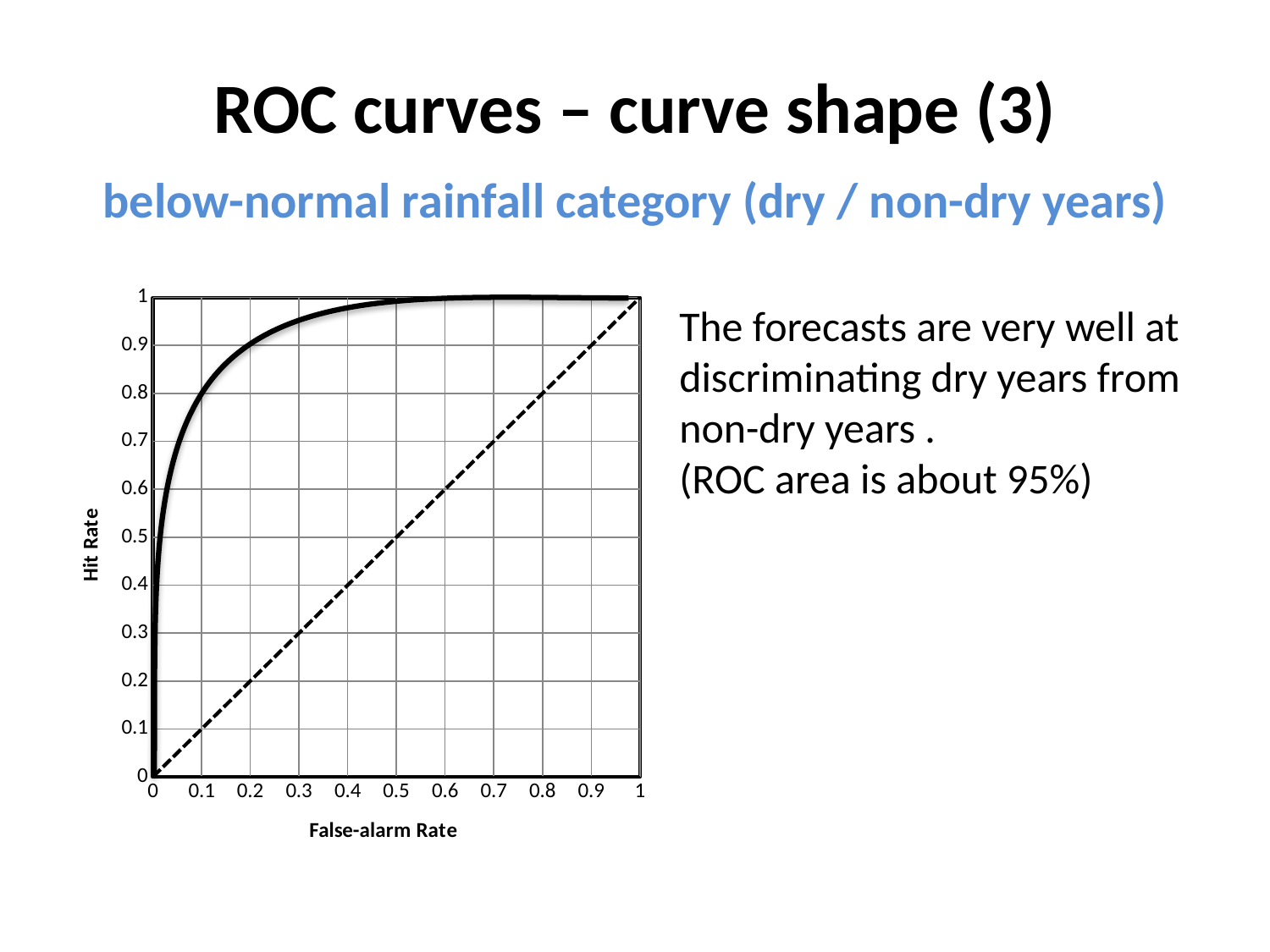
What is the hit rate of the solid curve when the false-alarm rate is 1? 1 What is the hit rate of the dashed line when the false-alarm rate is 0.5? 0.5 Does the solid curve rise or fall as the false-alarm rate increases? rise What is the title of the y axis? Hit Rate At a false-alarm rate of 0.1, is the hit rate of the solid curve greater or less than 0.7? greater What kind of chart is shown on the slide? line chart At a false-alarm rate of 0.2, is the hit rate of the solid curve greater or less than 0.8? greater At a false-alarm rate of 0.3, is the hit rate of the dashed line greater or less than 0.5? less What is the title of the x axis? False-alarm Rate How many lines are plotted on the chart? 2 At a false-alarm rate of 0.3, which line has the higher hit rate, the solid curve or the dashed line? the solid curve